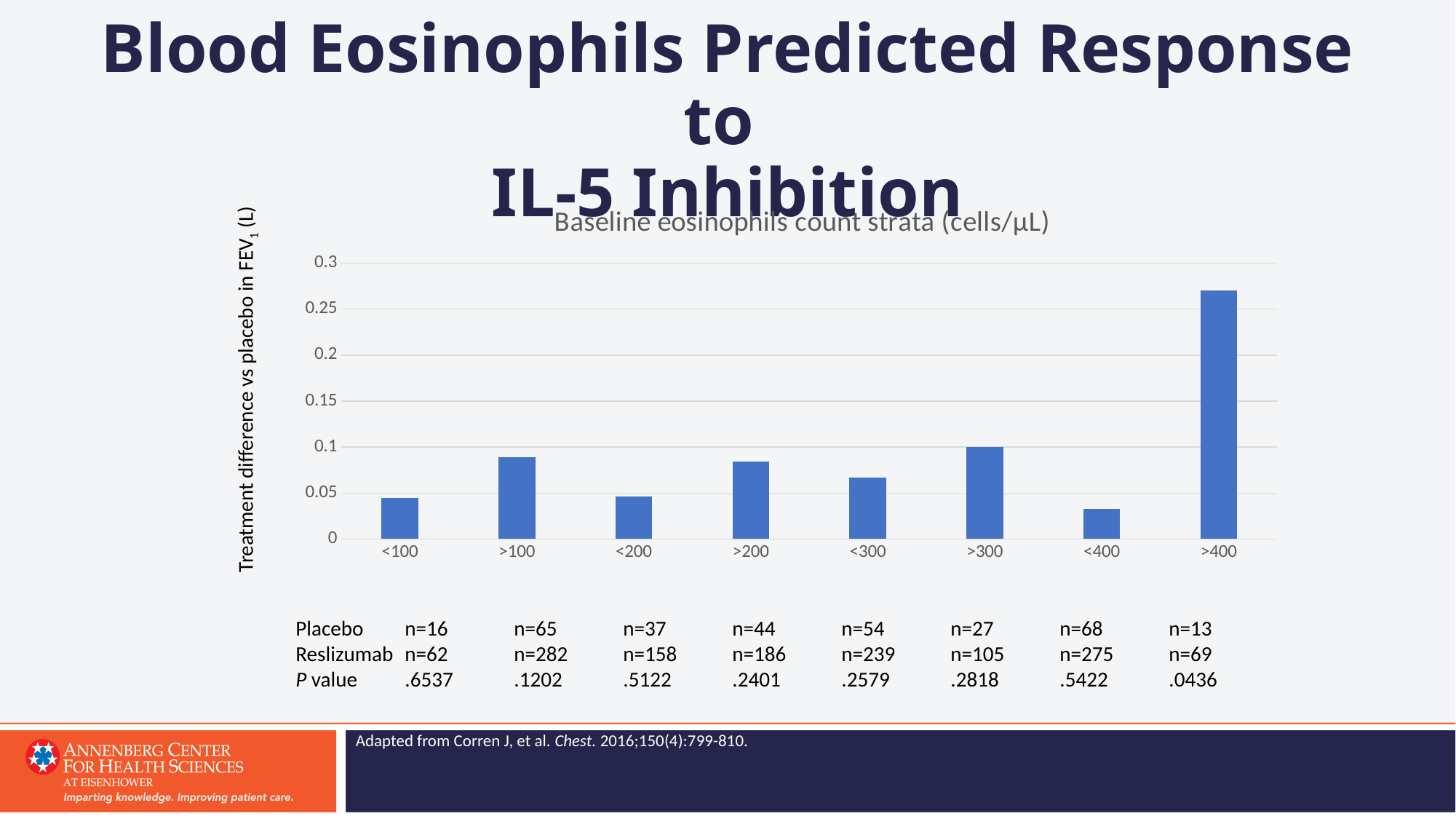
What is the title printed above the chart? Baseline eosinophils count strata (cells/µL) What kind of chart is shown on the slide? bar chart Which baseline eosinophil stratum has the highest treatment difference vs placebo in FEV1? >400 Is the treatment difference for the >400 stratum greater or less than 0.25? greater Which has the larger treatment difference vs placebo: the >200 stratum or the <200 stratum? >200 Which baseline eosinophil stratum has the lowest treatment difference vs placebo in FEV1? <400 Is the treatment difference for the <400 stratum greater or less than 0.05? less What is the label on the vertical axis of the chart? Treatment difference vs placebo in FEV1 (L) Is the treatment difference for the >100 stratum greater or less than 0.05? greater Which has the larger treatment difference vs placebo: the >300 stratum or the <300 stratum? >300 How many baseline eosinophil count strata are plotted on the x axis? 8